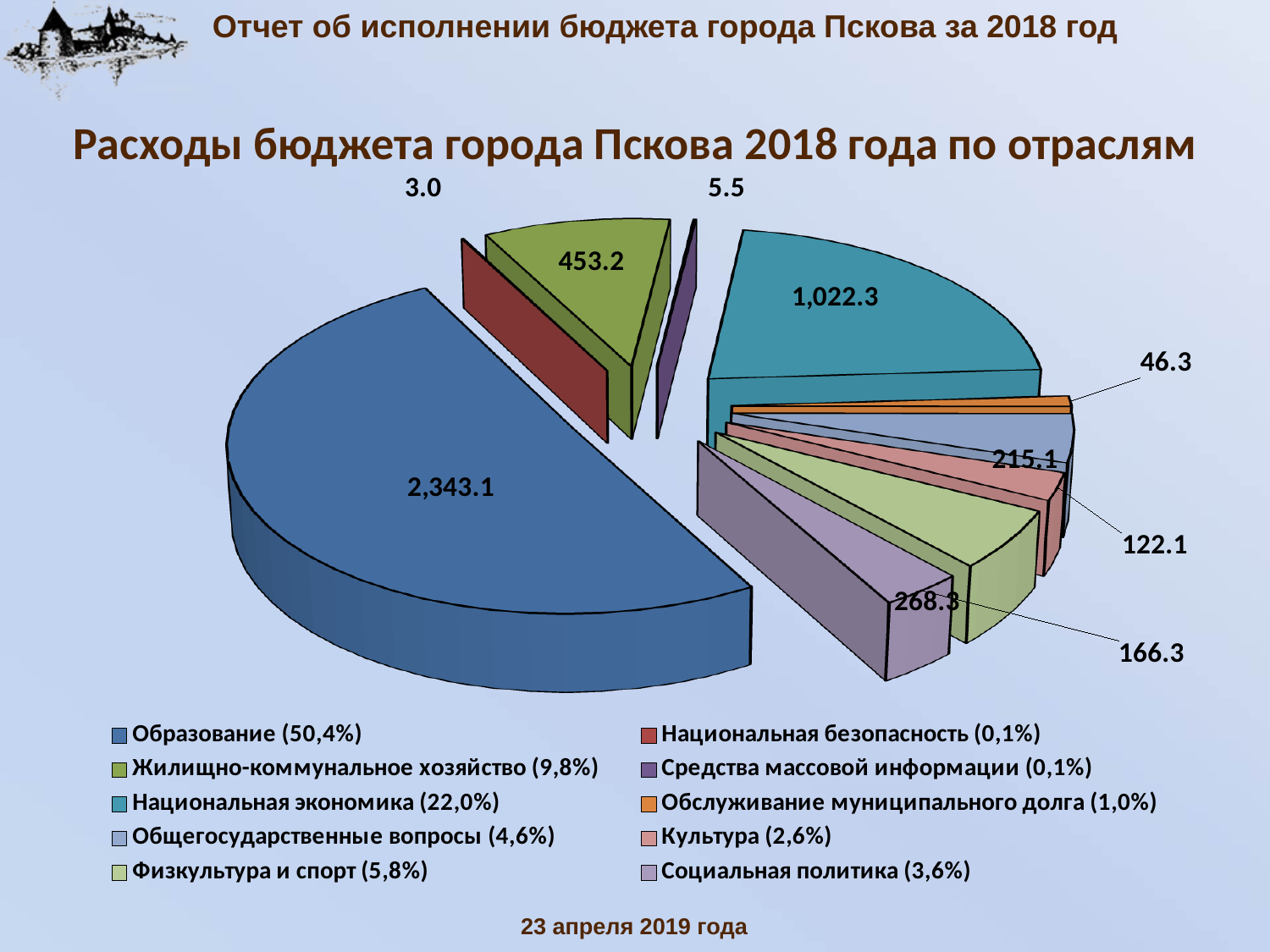
What is the difference between the values for Образование and Национальная экономика? 1,320.8 How many categories does the legend list? 10 What is the value shown for Жилищно-коммунальное хозяйство? 453.2 What kind of chart is shown on the slide? pie chart Which category has the smallest value in the pie chart? Национальная безопасность What is the value shown for Культура? 122.1 What share of the pie does Национальная экономика account for, according to the legend? 22,0% What share of the pie does Образование account for, according to the legend? 50,4% What is the value shown for Национальная экономика? 1,022.3 What is the value shown for Образование? 2,343.1 What is the value shown for Обслуживание муниципального долга? 46.3 Which category has the largest slice of the pie? Образование